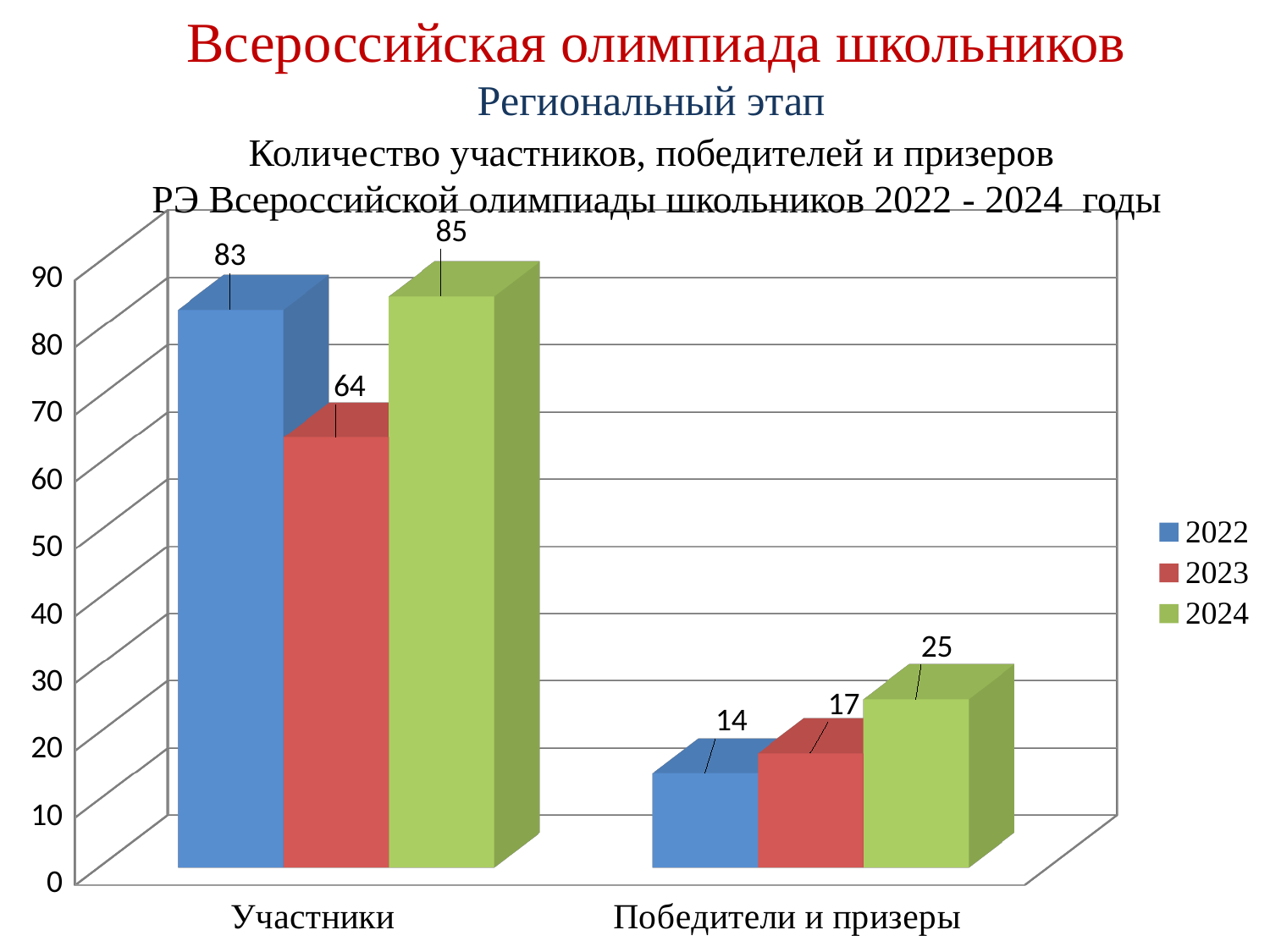
Which is larger in the Победители и призеры category: the value for 2023 or the value for 2024? 2024 What is the value for 2022 in the Участники category? 83 How many categories are shown on the x axis? 2 What is the value for 2024 in the Победители и призеры category? 25 How many series does the legend list? 3 Which year has the highest value in the Участники category? 2024 What kind of chart is shown on the slide? Bar chart What is the value for 2023 in the Участники category? 64 Which year has the lowest value in the Победители и призеры category? 2022 What is the difference between the 2024 and 2023 values in the Участники category? 21 What is the value for 2022 in the Победители и призеры category? 14 What is the difference between the 2024 and 2022 values in the Победители и призеры category? 11